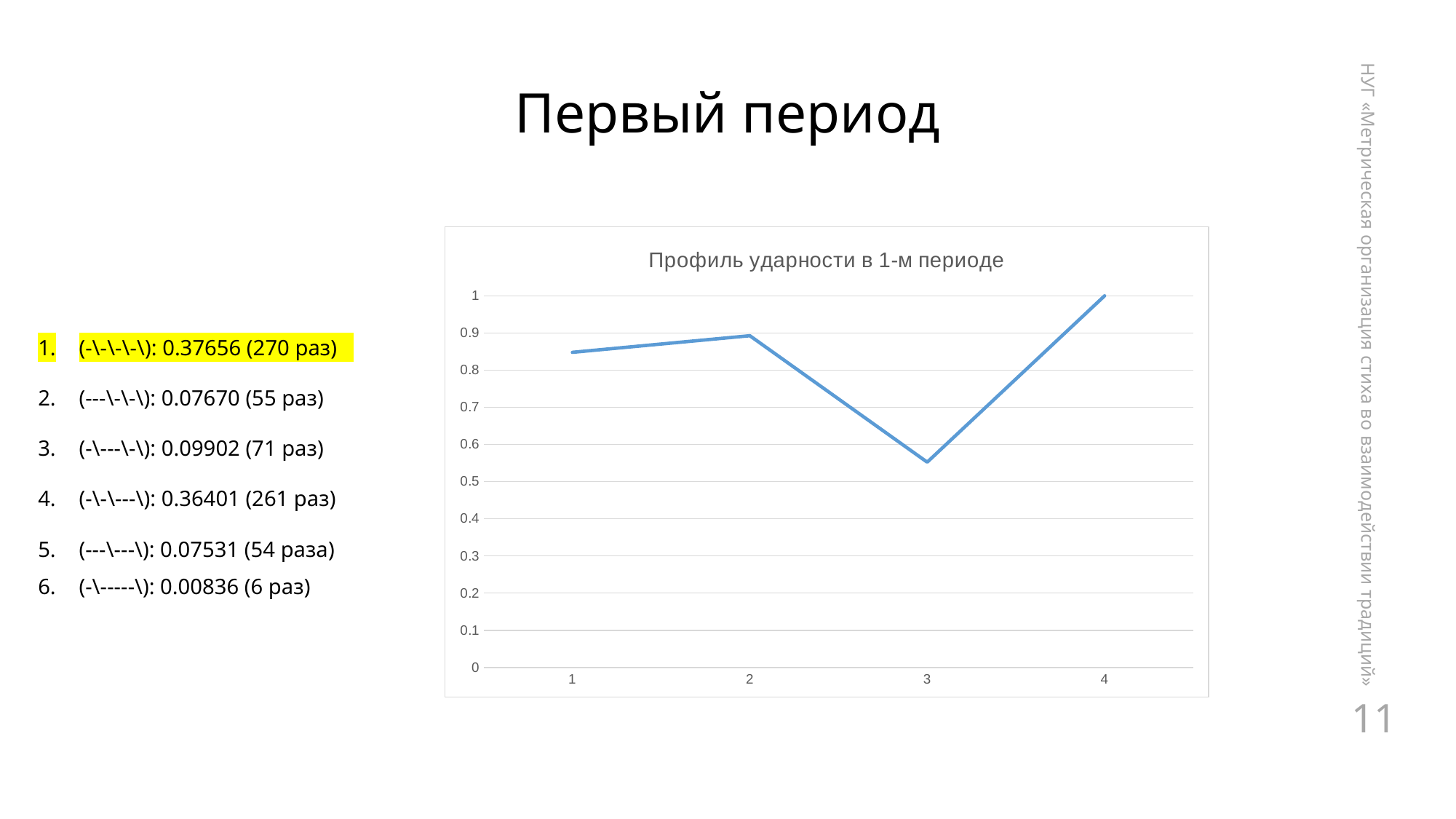
Is the value at x-axis position 3 greater or less than 0.6? less At which x-axis position does the line reach its highest value? 4 Is the value at x-axis position 3 greater or less than 0.5? greater Is the value at x-axis position 1 greater or less than 0.8? greater Does the line rise or fall between x-axis positions 3 and 4? rise What is the value of the line at x-axis position 4? 1 What is the title of the chart? Профиль ударности в 1-м периоде At which x-axis position does the line reach its lowest value? 3 Does the line rise or fall between x-axis positions 2 and 3? fall What kind of chart is shown on the slide? line chart How many points are plotted along the x axis of the chart? 4 Which has the larger value: x-axis position 1 or x-axis position 3? 1